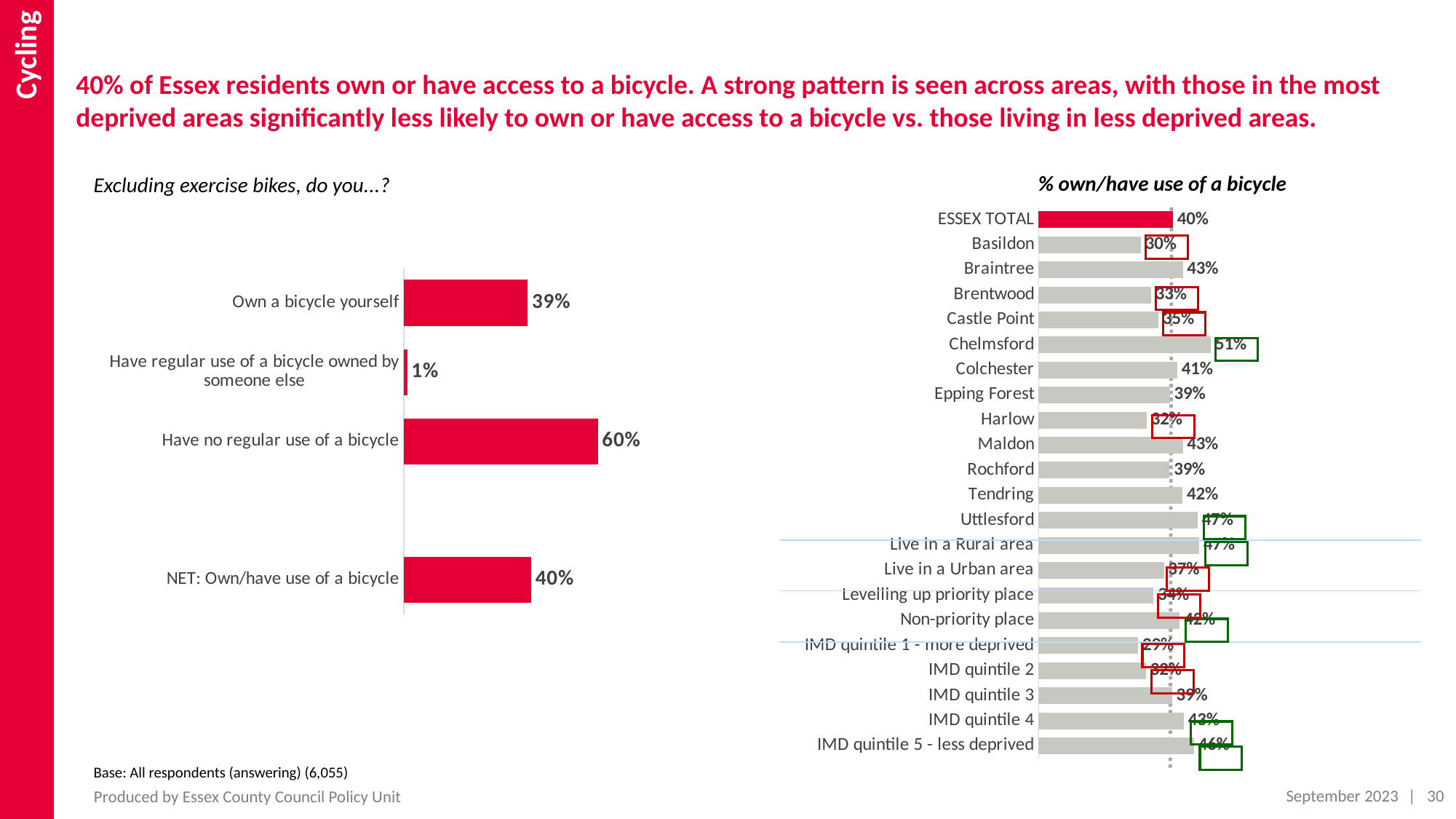
In the chart titled '% own/have use of a bicycle', what is the difference between Chelmsford and Basildon? 21 percentage points In the chart titled 'Excluding exercise bikes, do you...?', what percentage have no regular use of a bicycle? 60% In the chart titled 'Excluding exercise bikes, do you...?', which category has the lowest value? Have regular use of a bicycle owned by someone else In the chart titled '% own/have use of a bicycle', which district has the highest value? Chelmsford In the chart titled 'Excluding exercise bikes, do you...?', what is the difference between 'Have no regular use of a bicycle' and 'NET: Own/have use of a bicycle'? 20 percentage points In the chart titled '% own/have use of a bicycle', what is the value for Basildon? 30% What type of chart is the chart titled '% own/have use of a bicycle'? Bar chart In the chart titled 'Excluding exercise bikes, do you...?', how many categories are plotted? 4 In the chart titled '% own/have use of a bicycle', what is the value for Chelmsford? 51% In the chart titled '% own/have use of a bicycle', how many categories are plotted? 22 In the chart titled 'Excluding exercise bikes, do you...?', what percentage of respondents own a bicycle themselves? 39% In the chart titled '% own/have use of a bicycle', which is larger, Harlow or Colchester? Colchester